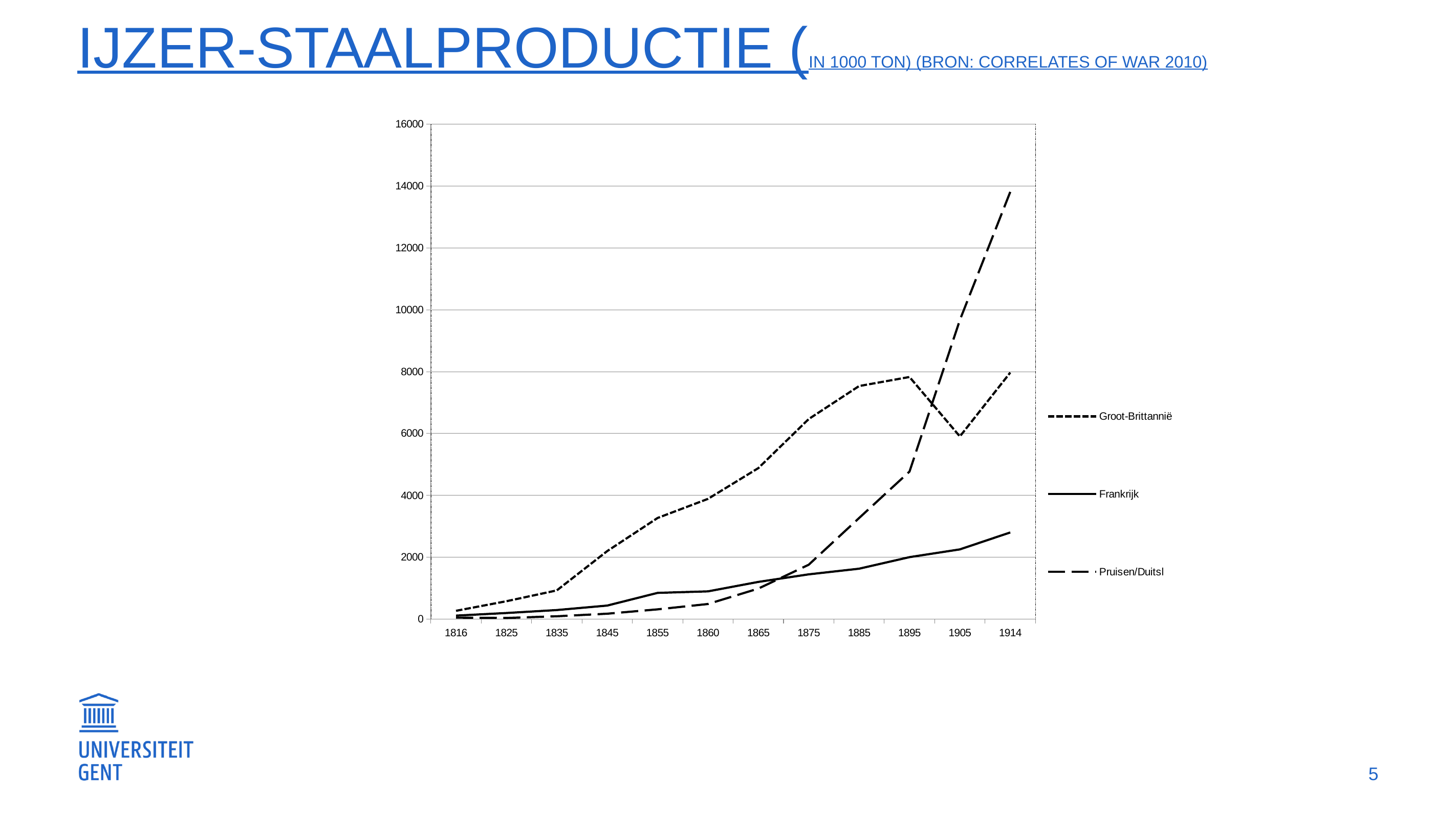
Which series is drawn with a solid line? Frankrijk How many years are marked along the x axis? 12 Which series has the highest value in 1914? Pruisen/Duitsl What kind of chart is shown on the slide? line chart How many series does the legend list? 3 Which series has the lowest value in 1914? Frankrijk Is the value for Groot-Brittannië in 1885 greater or less than 6000? greater Does the value for Frankrijk rise or fall from 1816 to 1914? rise Is the value for Pruisen/Duitsl in 1914 greater or less than 12000? greater In 1885, which is larger: the value for Groot-Brittannië or for Pruisen/Duitsl? Groot-Brittannië Is the value for Pruisen/Duitsl in 1895 greater or less than 4000? greater